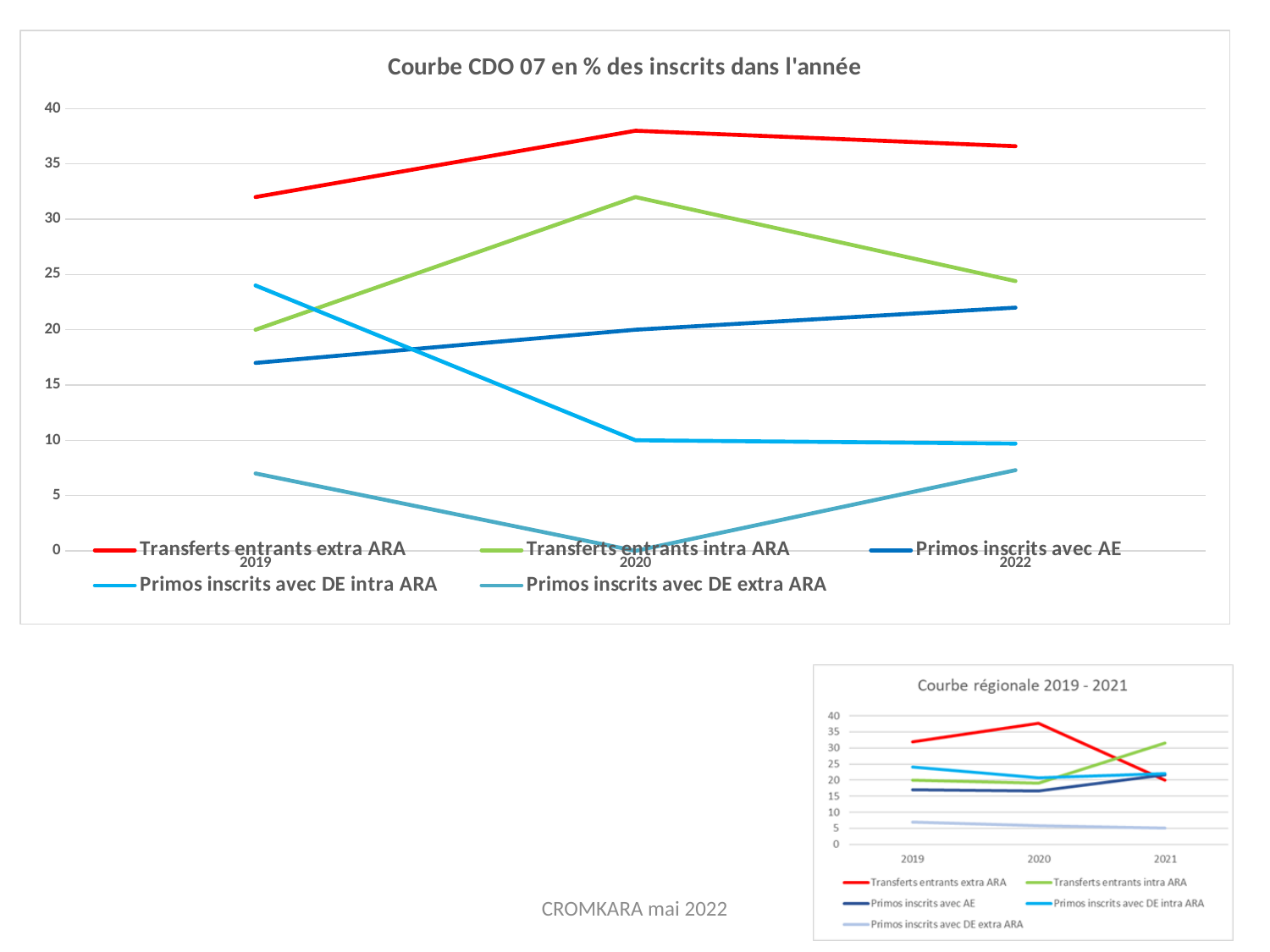
In 'Courbe CDO 07 en % des inscrits dans l'année', is the value for Primos inscrits avec DE intra ARA in 2020 greater or less than 15? less In 'Courbe CDO 07 en % des inscrits dans l'année', is the value for Transferts entrants extra ARA in 2019 greater or less than 30? greater In 'Courbe CDO 07 en % des inscrits dans l'année', does the Primos inscrits avec AE series rise or fall from 2019 to 2022? rise What is the title of the large chart at the top of the slide? Courbe CDO 07 en % des inscrits dans l'année In 'Courbe régionale 2019 - 2021', is the value for Transferts entrants extra ARA in 2020 greater or less than 35? greater In 'Courbe CDO 07 en % des inscrits dans l'année', which series has the highest value in 2020? Transferts entrants extra ARA How many points are on the x axis of 'Courbe CDO 07 en % des inscrits dans l'année'? 3 In 'Courbe CDO 07 en % des inscrits dans l'année', which is larger in 2019: Transferts entrants intra ARA or Primos inscrits avec DE intra ARA? Primos inscrits avec DE intra ARA How many series does the legend of 'Courbe CDO 07 en % des inscrits dans l'année' list? 5 In 'Courbe CDO 07 en % des inscrits dans l'année', which series has the lowest value in 2019? Primos inscrits avec DE extra ARA What kind of chart is 'Courbe CDO 07 en % des inscrits dans l'année'? line chart What is the title of the small chart at the bottom right of the slide? Courbe régionale 2019 - 2021